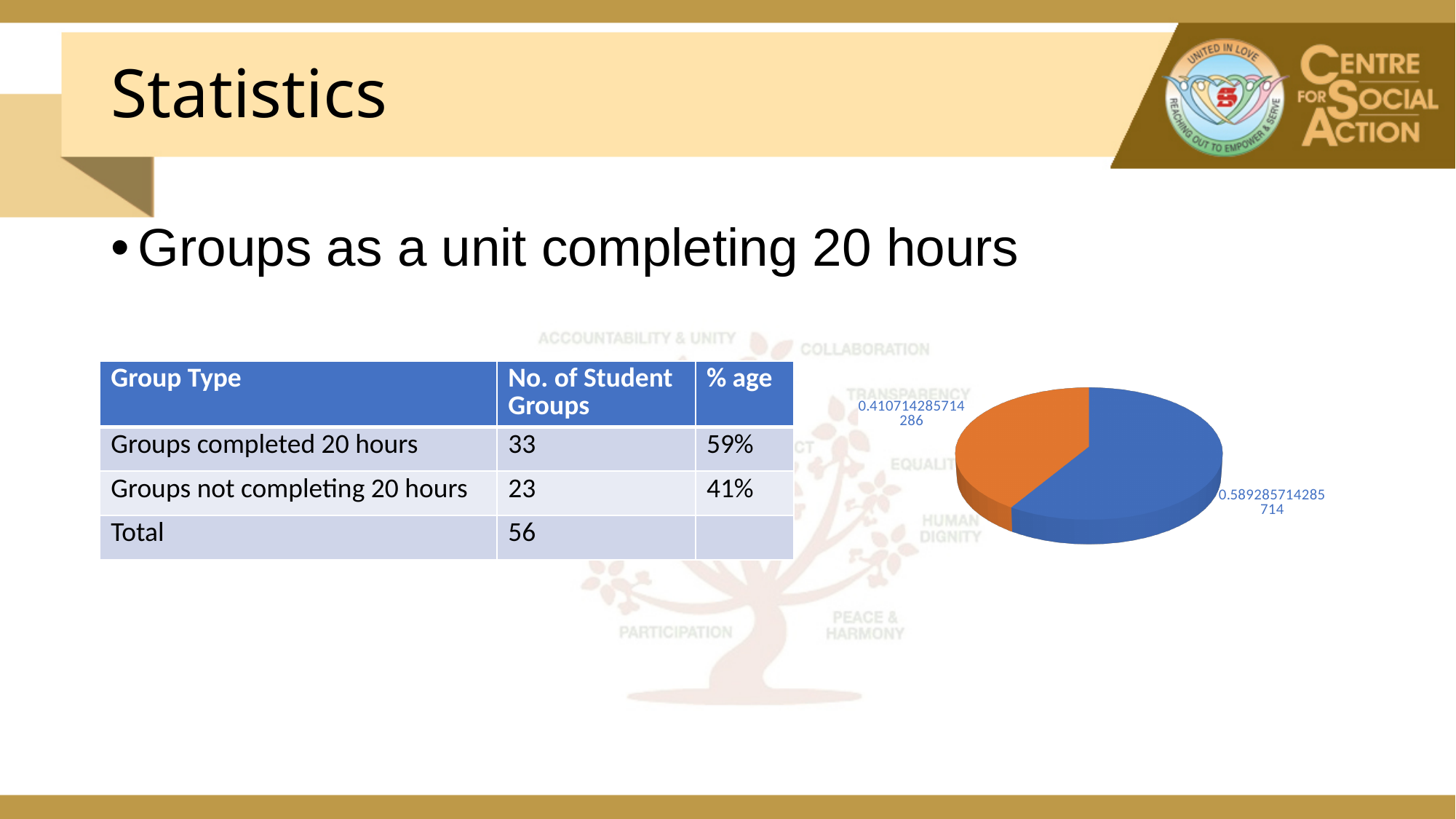
What is the difference between the labelled values of the blue slice and the orange slice? 0.178571428571428 Which is larger in the pie chart, the blue slice or the orange slice? the blue slice What kind of chart is shown on the slide? pie chart How many slices does the pie chart have? 2 Which slice of the pie chart is the smallest? the orange slice What value is labelled on the orange slice of the pie chart? 0.410714285714286 What share of the pie does the blue slice represent, as labelled on the chart? 0.589285714285714 Is the pie chart drawn in 3D or flat 2D? 3D Does the pie chart include a legend? No What value is labelled on the blue slice of the pie chart? 0.589285714285714 Which slice of the pie chart is the largest? the blue slice